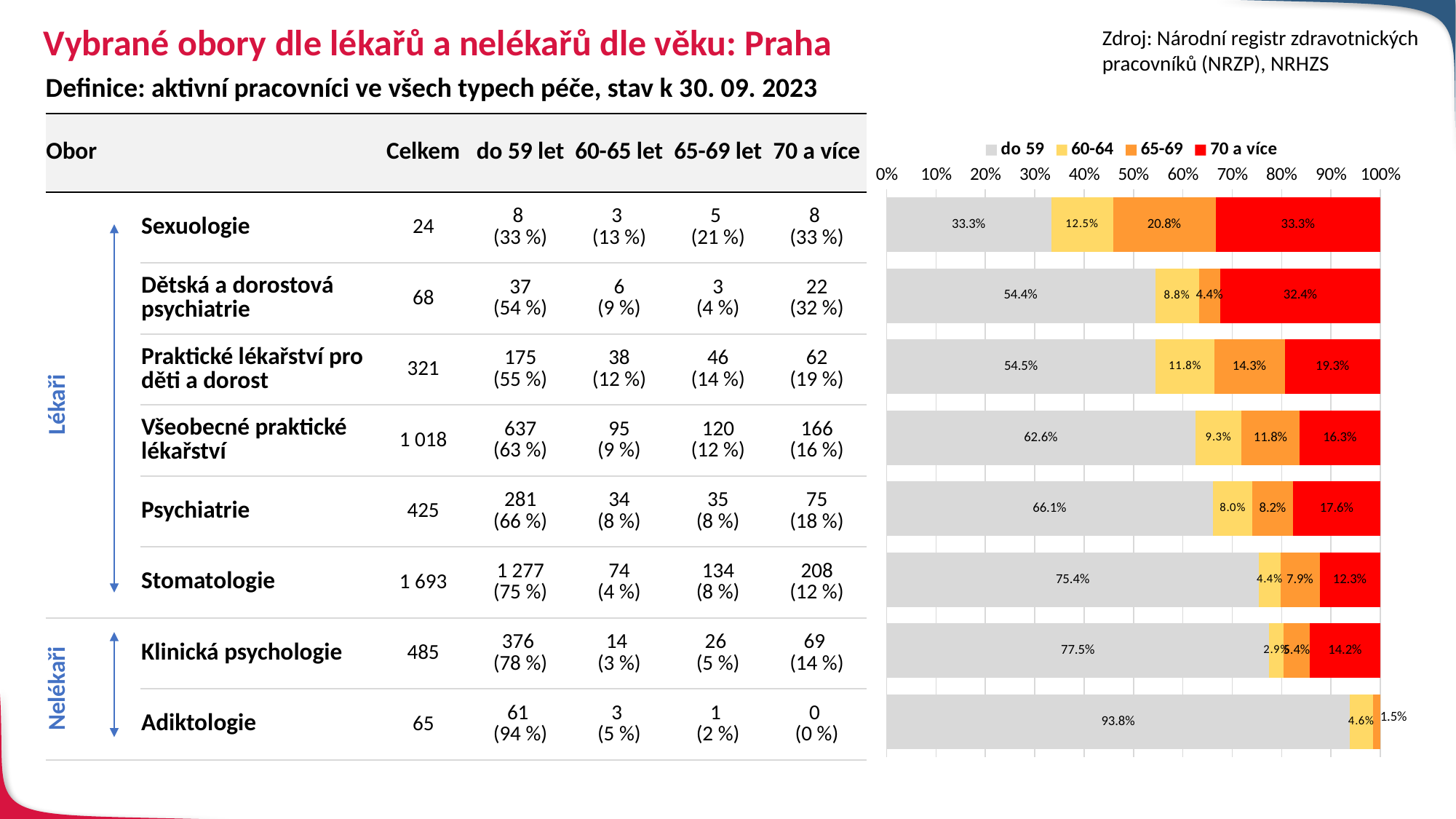
In the bar chart, which colour represents the '70 a více' series? red In the bar chart, which bar has the largest 'do 59' segment? Adiktologie (bottom bar), 93.8% In the bar chart, which bar has the smallest 'do 59' segment? Sexuologie (top bar), 33.3% In the bar chart, what is the difference in percentage points between the 'do 59' share of Stomatologie (75.4%) and Psychiatrie (66.1%)? 9.3 percentage points In the bar chart, what is the '70 a více' share shown on the Stomatologie bar? 12.3% How many bars are plotted in the bar chart? 8 In the bar chart, what is the 'do 59' share shown on the top bar (Sexuologie)? 33.3% What kind of chart is shown on the right side of the slide? bar chart In the bar chart, does the 'do 59' share rise or fall going from the top bar to the bottom bar? rise In the bar chart, what is the '60-64' share shown on the Klinická psychologie bar? 2.9% In the bar chart, is the '65-69' share larger for Sexuologie (top bar) or for Praktické lékařství pro děti a dorost (third bar)? Sexuologie How many series does the legend of the bar chart list? 4